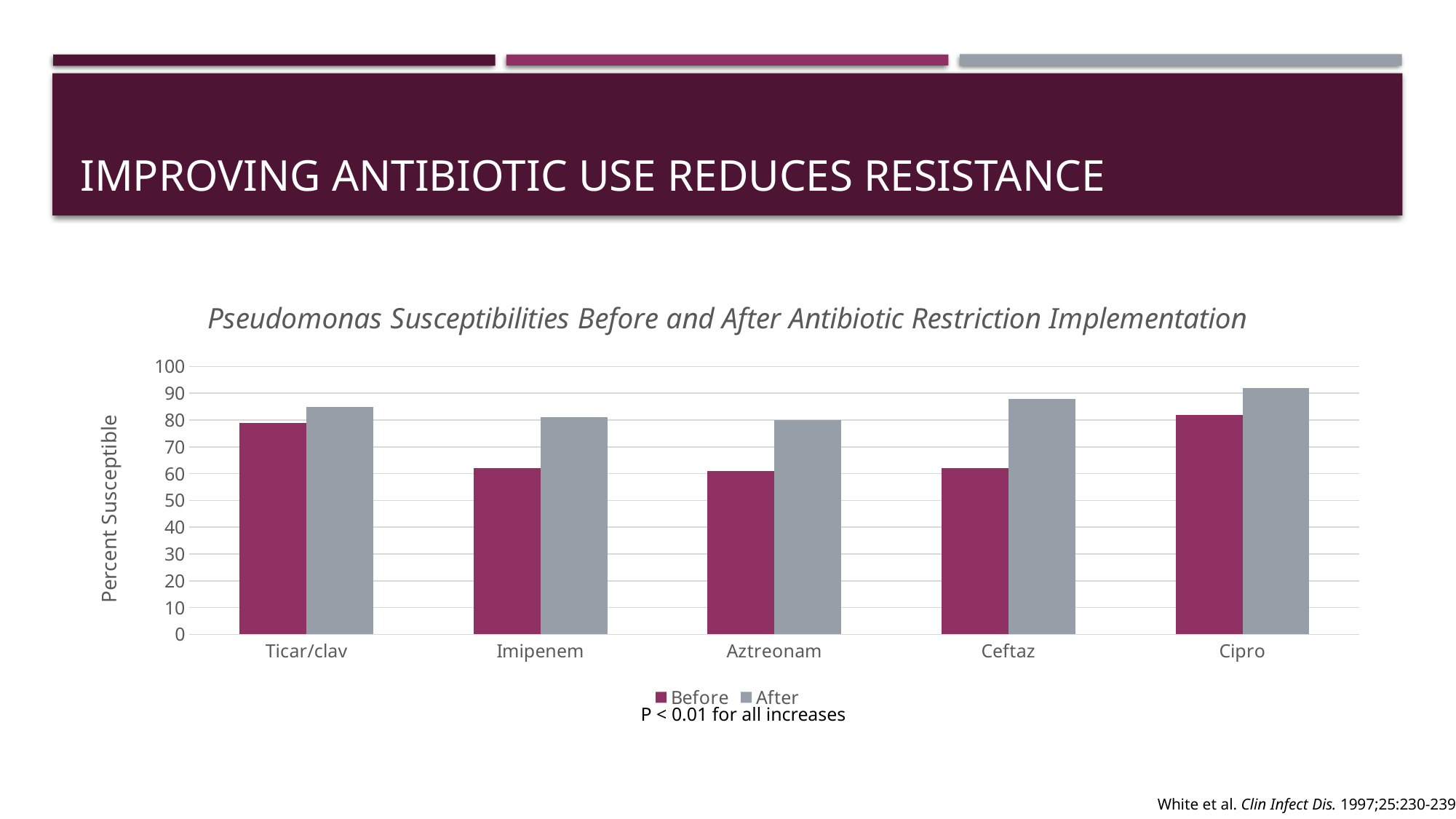
Is the After value for Cipro greater or less than 80? greater How many series does the legend list? 2 What is the label on the y axis of the chart? Percent Susceptible Which antibiotic has the highest After value? Cipro Is the Before value for Ticar/clav greater or less than 70? greater Is the Before value for Ceftaz greater or less than 70? less How many antibiotics (categories) are shown on the x axis? 5 For Ceftaz, which is larger, the Before value or the After value? After Which is larger, the Before value for Cipro or the Before value for Imipenem? Cipro Which antibiotic has the highest Before value? Cipro What kind of chart is shown on the slide? Bar chart